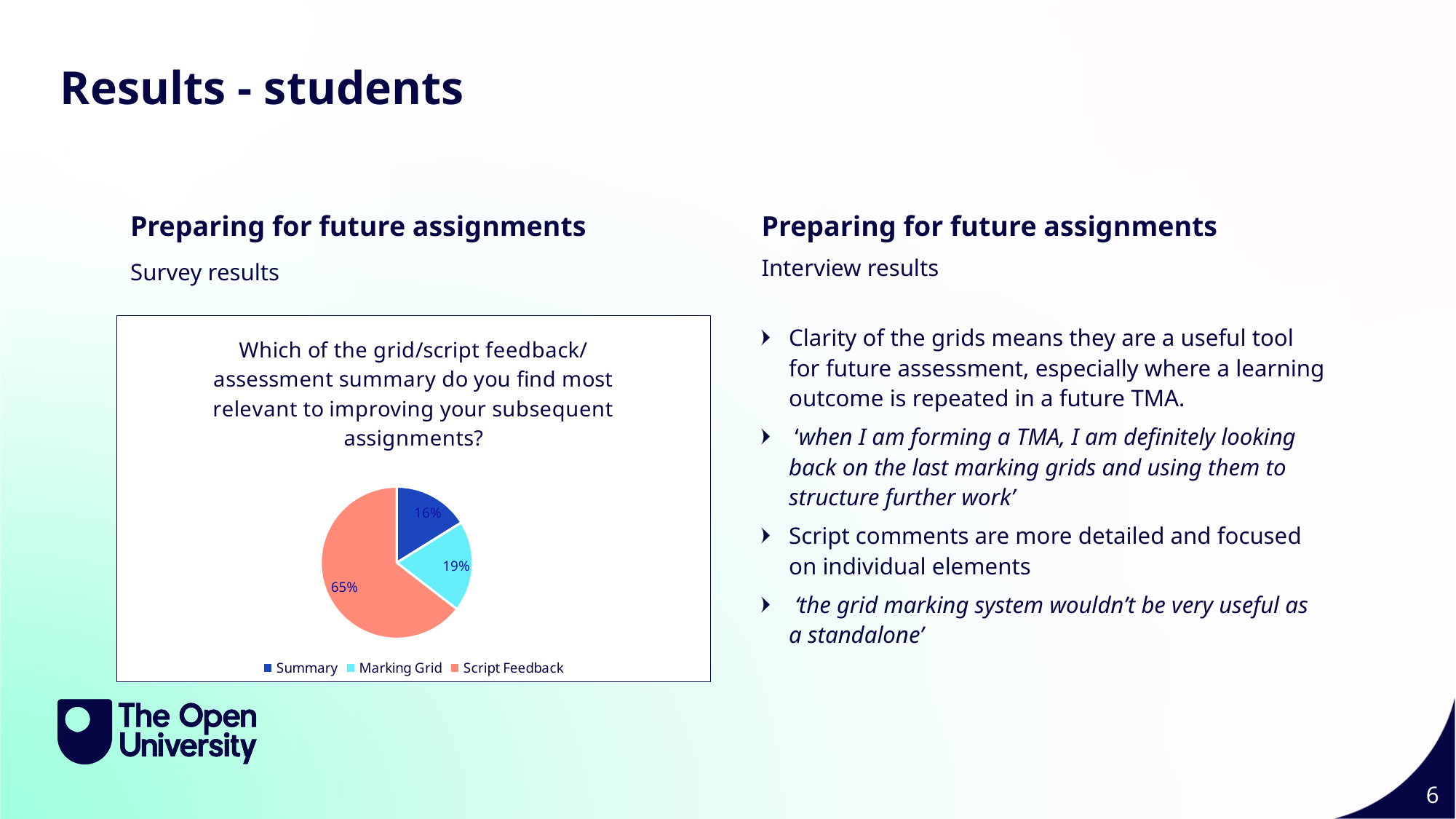
What is the difference in percentage points between Script Feedback and Marking Grid? 46 What is the difference in percentage points between Marking Grid and Summary? 3 What question does the chart title ask? Which of the grid/script feedback/assessment summary do you find most relevant to improving your subsequent assignments? Which option has the smallest share of the pie? Summary What percentage of students chose Script Feedback as most relevant to improving subsequent assignments? 65% How many categories does the pie chart show? 3 What colour is the Script Feedback slice? salmon/orange What percentage of students chose Summary? 16% Which option has the largest share of the pie? Script Feedback What kind of chart is shown on the slide? pie chart What percentage of students chose Marking Grid? 19% Which has a larger share, Summary or Script Feedback? Script Feedback